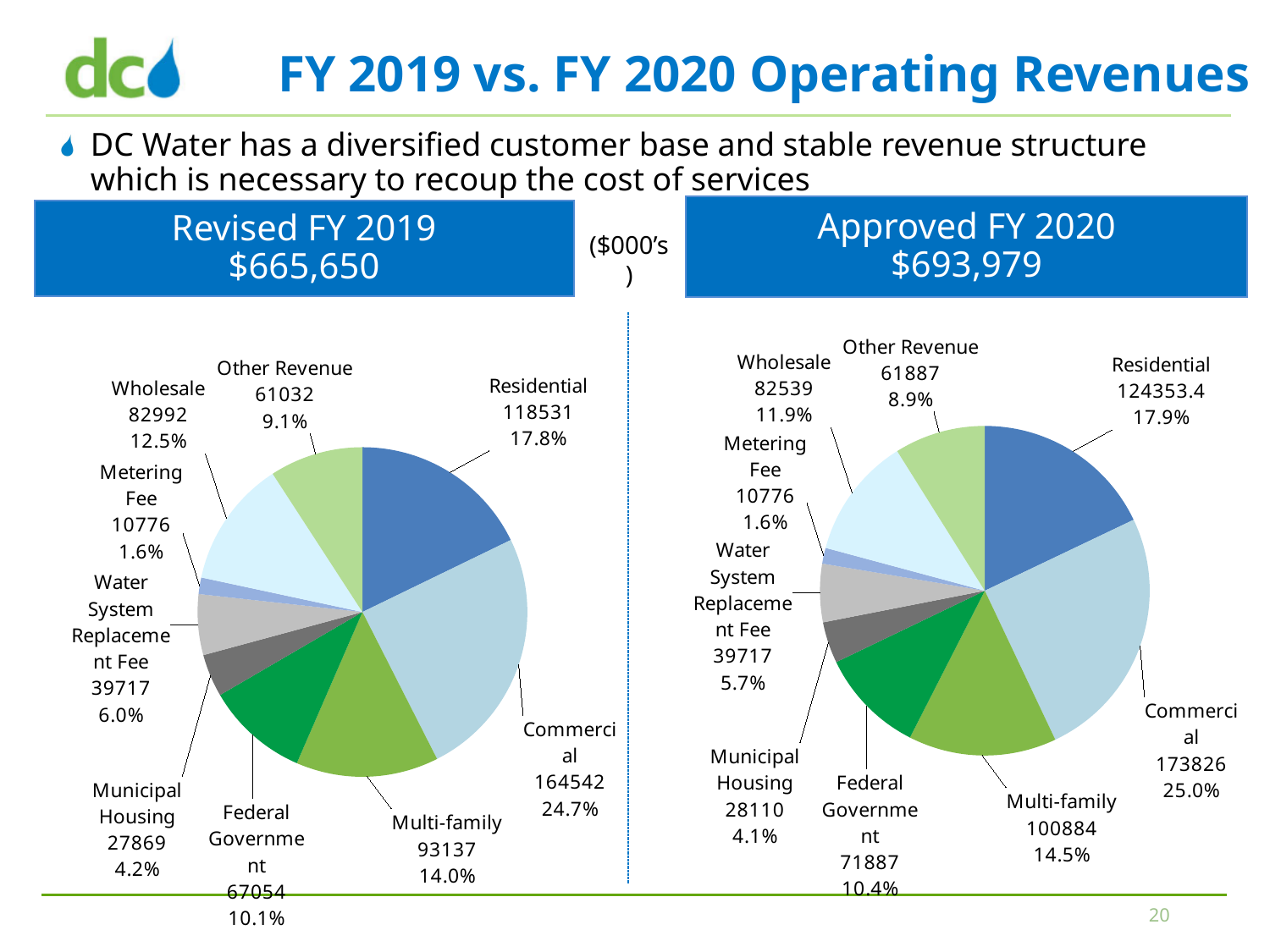
What type of chart is used to show the Approved FY 2020 operating revenues? Pie chart In the Revised FY 2019 pie chart, what is the difference between the Wholesale value and the Other Revenue value? 21960 What is the difference between the Commercial value in the Approved FY 2020 chart and the Commercial value in the Revised FY 2019 chart? 9284 How many categories are shown in the Revised FY 2019 pie chart? 9 What total is shown in the header above the Approved FY 2020 pie chart? $693,979 In the Revised FY 2019 pie chart, which category has the largest slice? Commercial In the Approved FY 2020 pie chart, what is the value for Multi-family? 100884 In the Approved FY 2020 pie chart, which category has the smallest slice? Metering Fee In the Approved FY 2020 pie chart, which is larger: Federal Government or Wholesale? Wholesale In the Approved FY 2020 pie chart, what share of the pie does Residential represent? 17.9% In the Revised FY 2019 pie chart, what share of the pie does Water System Replacement Fee represent? 6.0% In the Revised FY 2019 pie chart, what is the value for Commercial? 164542